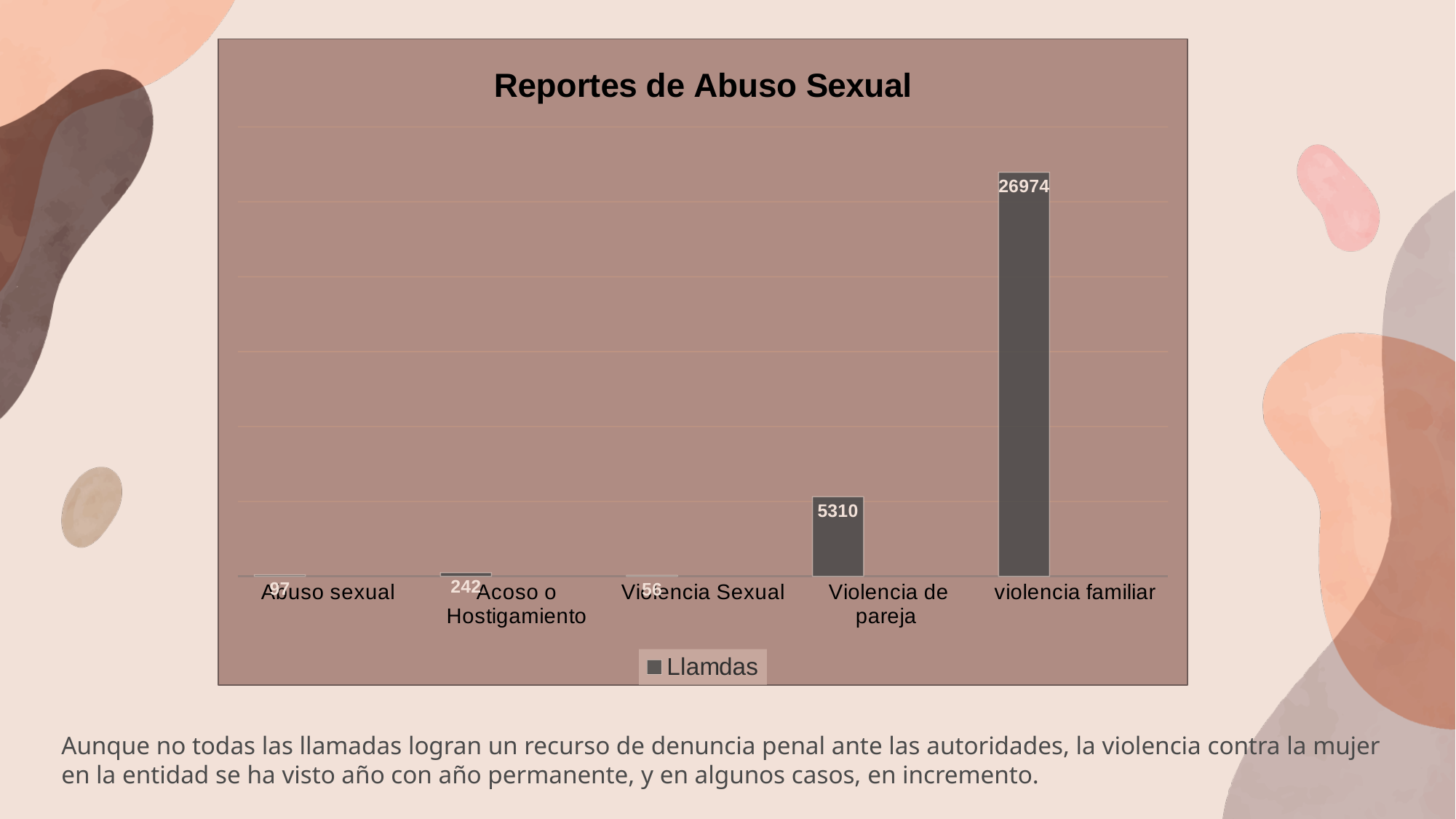
What is the difference between the values for violencia familiar and Violencia de pareja? 21664 How many series does the legend list? 1 Which category has the lowest value? Violencia Sexual What is the value for violencia familiar? 26974 What is the value for Acoso o Hostigamiento? 242 How many categories are shown on the x axis? 5 What kind of chart is shown on the slide? bar chart What is the value for Violencia de pareja? 5310 What is the title of the chart? Reportes de Abuso Sexual Which is larger, the value for Acoso o Hostigamiento or the value for Abuso sexual? Acoso o Hostigamiento What is the name of the series shown in the legend? Llamdas Which category has the highest value? violencia familiar